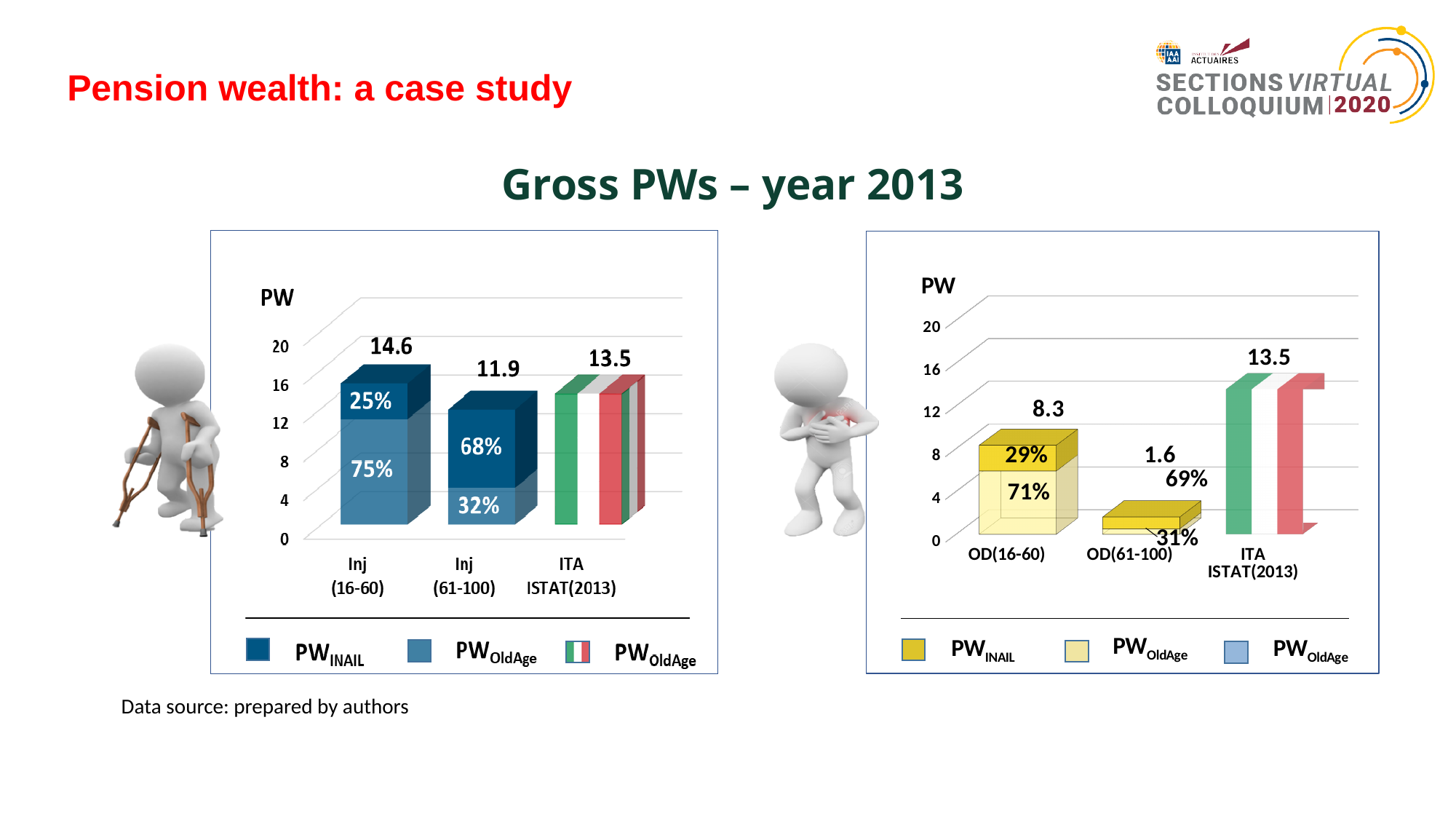
In the right chart, what is the total PW value shown for OD (61-100)? 1.6 In the left chart, what is the difference between the PW values for Inj (16-60) and Inj (61-100)? 2.7 In the right chart, what is the difference between the PW values for ITA ISTAT(2013) and OD (16-60)? 5.2 Which is larger: the PW value for Inj (16-60) in the left chart or the PW value for OD (16-60) in the right chart? Inj (16-60) In the left chart, what is the total PW value shown for Inj (16-60)? 14.6 How many categories are shown on the x axis of the right chart? 3 In the left chart, what is the total PW value shown for Inj (61-100)? 11.9 In the left chart, what percentage share is labelled for PW INAIL in the Inj (61-100) bar? 68% In the right chart, what percentage share is labelled for PW OldAge in the OD (16-60) bar? 71% In the right chart, which category has the lowest PW value? OD(61-100) In the left chart, which category has the highest total PW value? Inj (16-60) In the right chart, what is the total PW value shown for OD (16-60)? 8.3